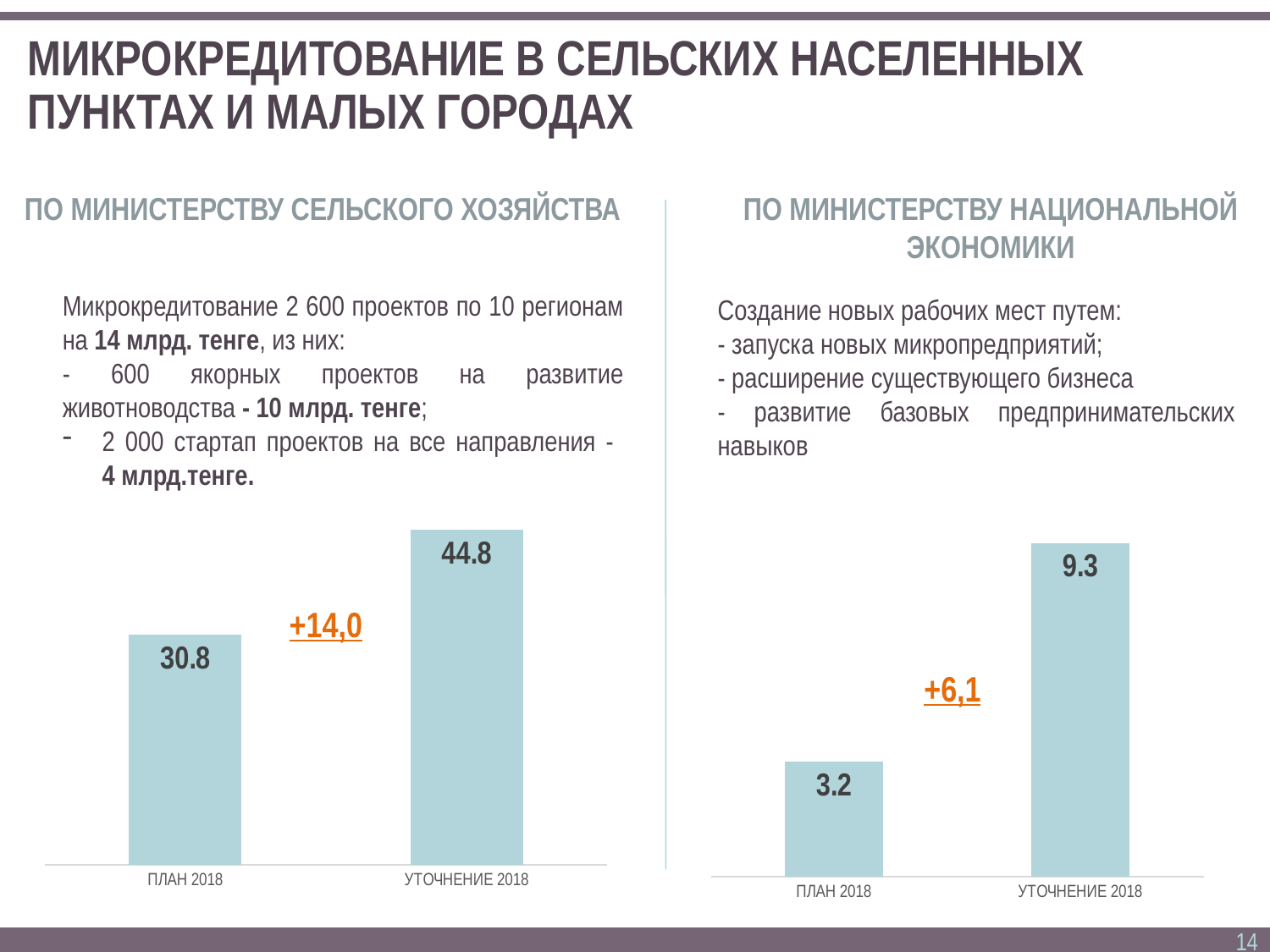
How many categories are shown in the left chart (ПО МИНИСТЕРСТВУ СЕЛЬСКОГО ХОЗЯЙСТВА)? 2 In the right chart (ПО МИНИСТЕРСТВУ НАЦИОНАЛЬНОЙ ЭКОНОМИКИ), is the value for ПЛАН 2018 larger or smaller than the value for УТОЧНЕНИЕ 2018? smaller In the right chart (ПО МИНИСТЕРСТВУ НАЦИОНАЛЬНОЙ ЭКОНОМИКИ), what is the value for УТОЧНЕНИЕ 2018? 9.3 In the right chart (ПО МИНИСТЕРСТВУ НАЦИОНАЛЬНОЙ ЭКОНОМИКИ), what is the value for ПЛАН 2018? 3.2 In the left chart (ПО МИНИСТЕРСТВУ СЕЛЬСКОГО ХОЗЯЙСТВА), what change is annotated in orange between the two bars? +14,0 In the left chart (ПО МИНИСТЕРСТВУ СЕЛЬСКОГО ХОЗЯЙСТВА), what is the difference between УТОЧНЕНИЕ 2018 and ПЛАН 2018? 14.0 In the left chart (ПО МИНИСТЕРСТВУ СЕЛЬСКОГО ХОЗЯЙСТВА), which category has the higher value? УТОЧНЕНИЕ 2018 In the right chart (ПО МИНИСТЕРСТВУ НАЦИОНАЛЬНОЙ ЭКОНОМИКИ), which category has the lowest value? ПЛАН 2018 In the right chart (ПО МИНИСТЕРСТВУ НАЦИОНАЛЬНОЙ ЭКОНОМИКИ), what is the difference between УТОЧНЕНИЕ 2018 and ПЛАН 2018? 6.1 What type of chart is the right chart (ПО МИНИСТЕРСТВУ НАЦИОНАЛЬНОЙ ЭКОНОМИКИ)? bar chart In the left chart (ПО МИНИСТЕРСТВУ СЕЛЬСКОГО ХОЗЯЙСТВА), what is the value for УТОЧНЕНИЕ 2018? 44.8 In the left chart (ПО МИНИСТЕРСТВУ СЕЛЬСКОГО ХОЗЯЙСТВА), what is the value for ПЛАН 2018? 30.8